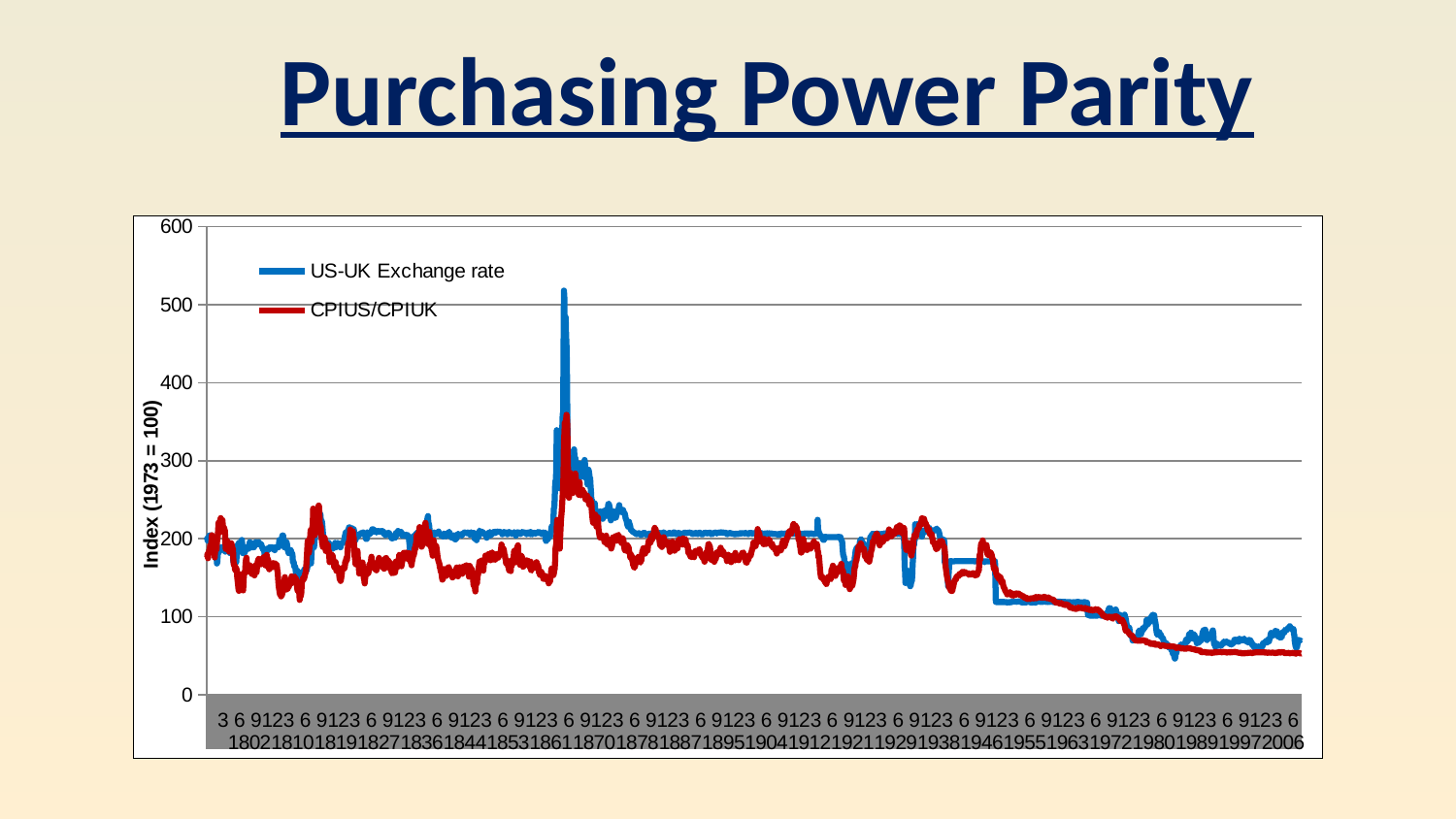
What is the title of the slide's chart? Purchasing Power Parity Is the value of the CPIUS/CPIUK series at the right end of the chart (around 2006) greater or less than 100? less How many series does the legend list? 2 What is the highest tick value shown on the vertical axis? 600 What kind of chart is shown on the slide? line chart Which series reaches the higher peak, US-UK Exchange rate or CPIUS/CPIUK? US-UK Exchange rate Is the highest peak of the US-UK Exchange rate series greater or less than 400? greater Is the value of the US-UK Exchange rate series at the left end of the chart (around 1802) greater or less than 100? greater Which series is drawn in blue? US-UK Exchange rate Overall, do the plotted values rise or fall from the left of the x axis to the right? fall